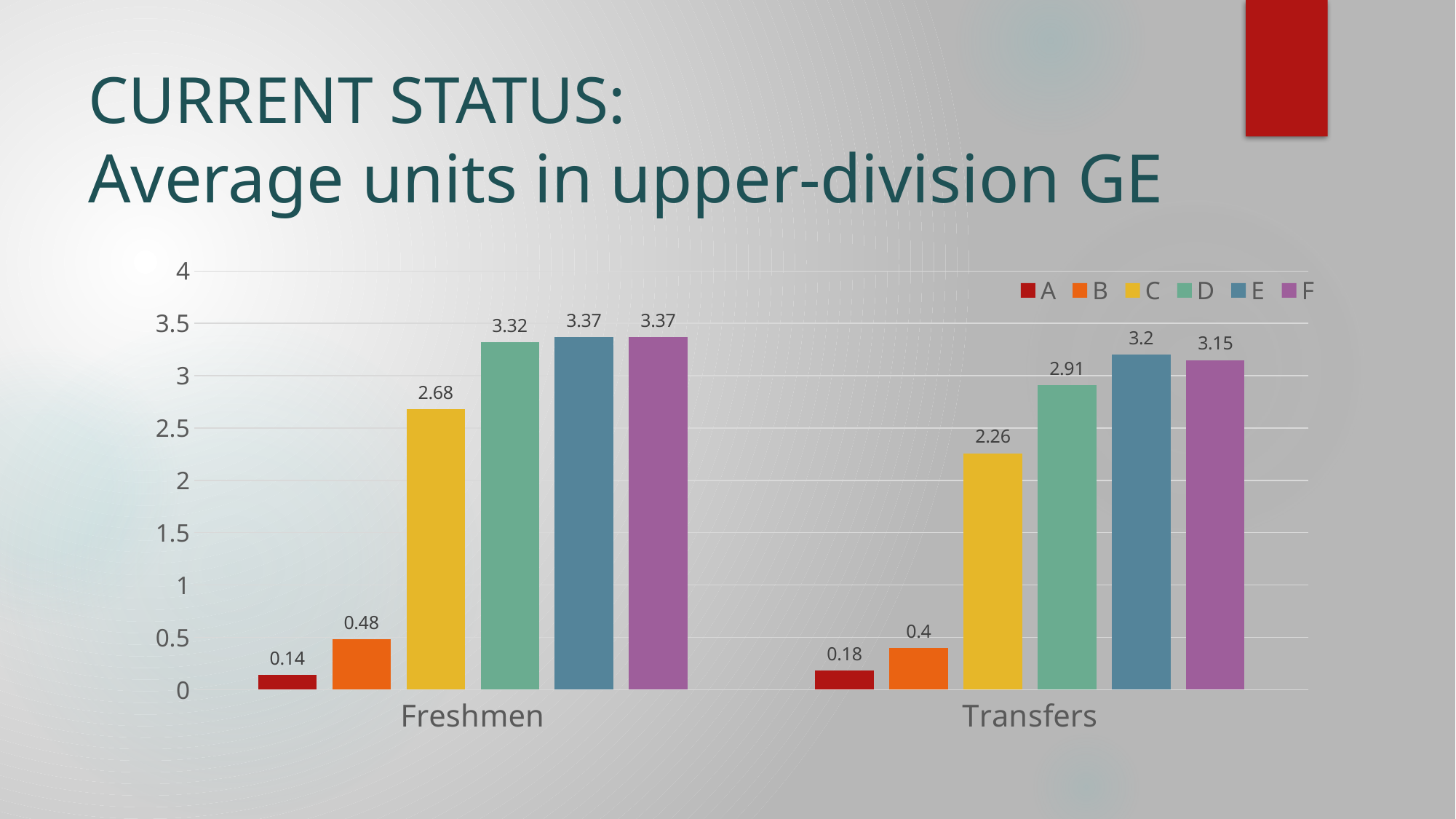
What kind of chart is shown on the slide? Bar chart Which series has the lowest value in the Freshmen category? A How many categories are shown on the x axis? 2 What is the value for series C in the Freshmen category? 2.68 What is the difference between series D for Freshmen and series D for Transfers? 0.41 How many series does the legend list? 6 Which is larger: series C for Freshmen or series C for Transfers? Freshmen What is the value for series E in the Transfers category? 3.2 Is the value for series D in the Transfers category greater or less than 3? less Which series has the lowest value in the Transfers category? A What is the value for series A in the Freshmen category? 0.14 What is the value for series B in the Transfers category? 0.4